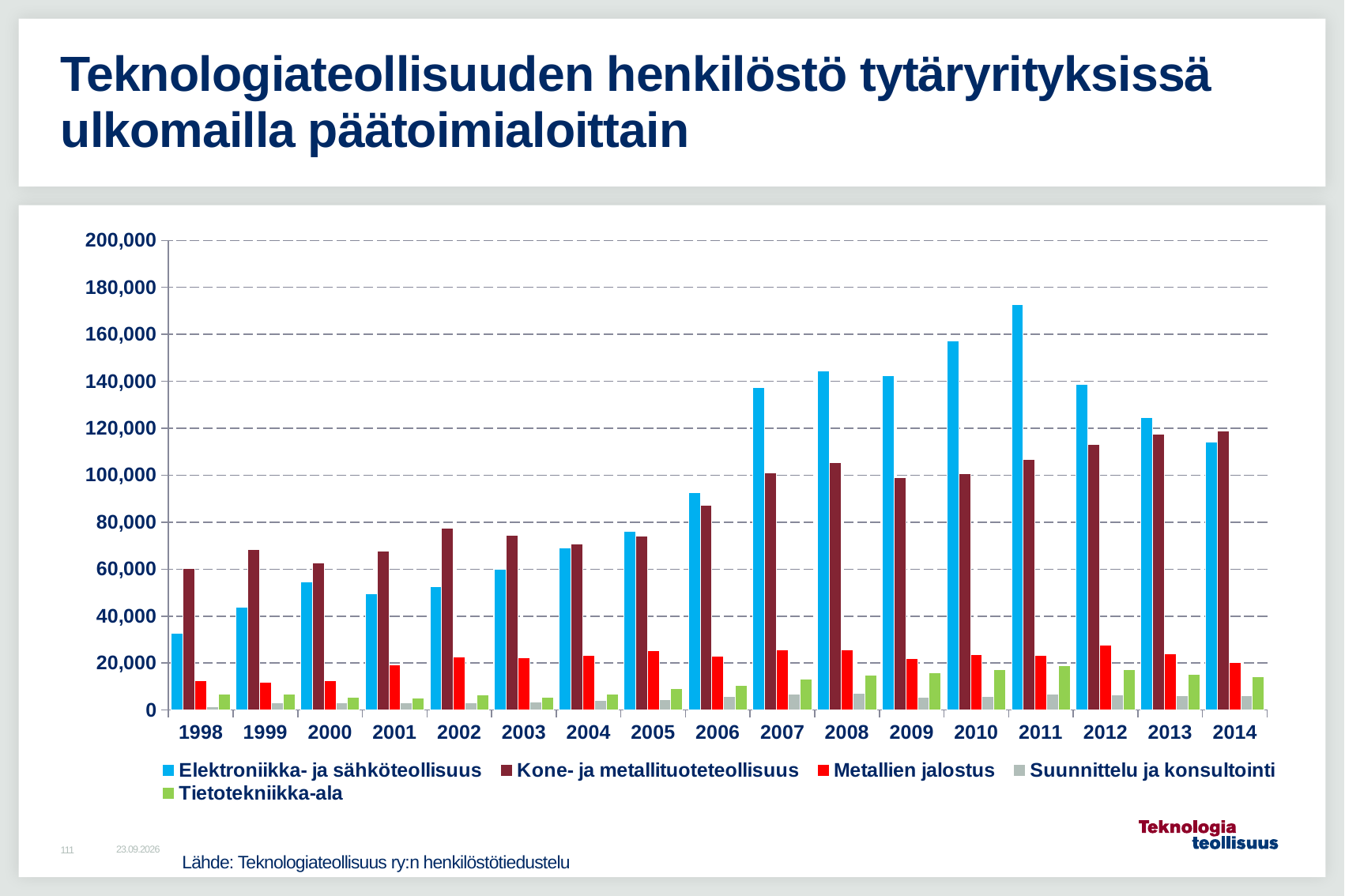
Is the value for Elektroniikka- ja sähköteollisuus in 1998 greater or less than 40,000? less In which year is the value for Elektroniikka- ja sähköteollisuus lowest? 1998 What kind of chart is shown on the slide? Bar chart In 2007, which is larger: Elektroniikka- ja sähköteollisuus or Kone- ja metallituoteteollisuus? Elektroniikka- ja sähköteollisuus How many series does the legend list? 5 Does the value for Elektroniikka- ja sähköteollisuus rise or fall from 2011 to 2014? Fall Which series is shown in light blue in the legend? Elektroniikka- ja sähköteollisuus Is the value for Metallien jalostus in 2012 greater or less than 20,000? greater How many years are shown on the x axis? 17 Is the value for Elektroniikka- ja sähköteollisuus in 2011 greater or less than 160,000? greater In which year is the value for Elektroniikka- ja sähköteollisuus highest? 2011